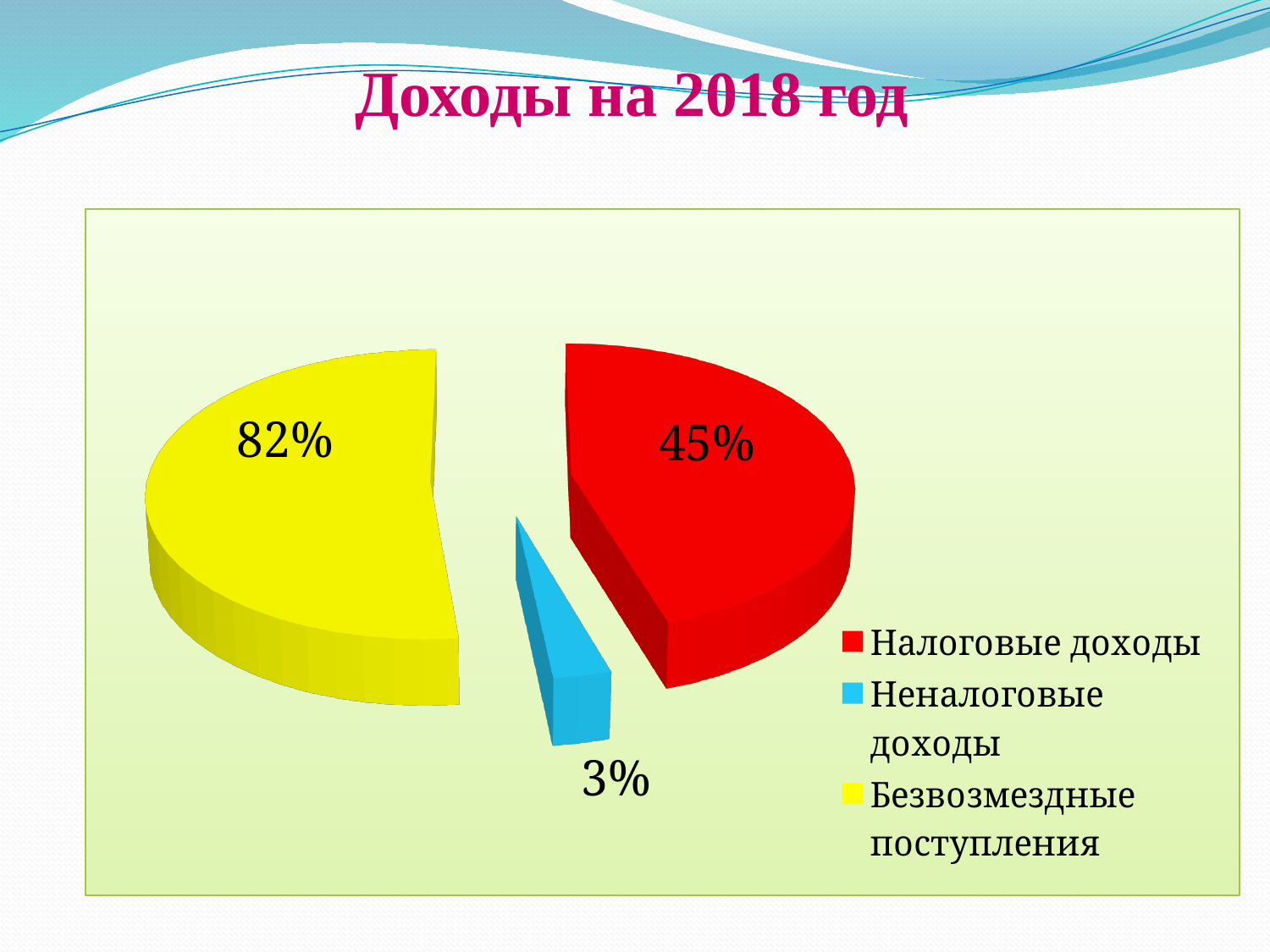
What is the difference in percentage points between Налоговые доходы and Неналоговые доходы? 42 What colour is the slice for Безвозмездные поступления? Yellow Which category has the largest slice of the pie? Безвозмездные поступления What is the difference in percentage points between Безвозмездные поступления and Налоговые доходы? 37 What percentage is shown for Неналоговые доходы? 3% How many slices does the pie chart have? 3 What percentage is shown for Безвозмездные поступления? 82% What is the title of the slide? Доходы на 2018 год Which category has the smallest slice of the pie? Неналоговые доходы What type of chart is shown on the slide? Pie chart Which is larger, Налоговые доходы or Неналоговые доходы? Налоговые доходы What percentage is shown for Налоговые доходы? 45%